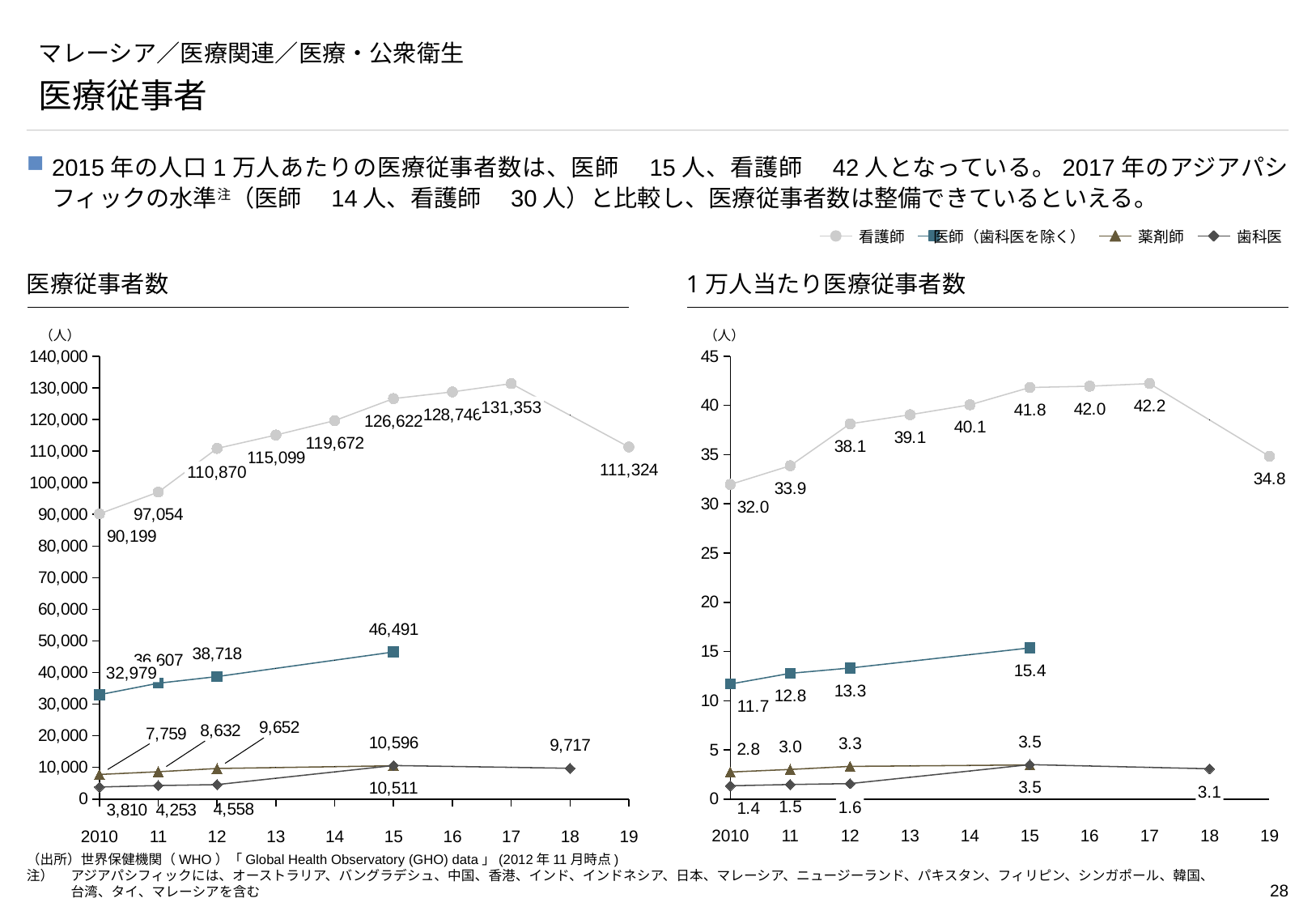
On the 1万人当たり医療従事者数 chart, what is the value for 医師（歯科医を除く） in 2015? 15.4 On the 医療従事者数 chart, what is the difference between the 看護師 values in 2017 and 2019? 20,029 On the 1万人当たり医療従事者数 chart, is the 看護師 value in 2019 greater or less than 35? less On the 1万人当たり医療従事者数 chart, what is the value for 看護師 in 2015? 41.8 On the 1万人当たり医療従事者数 chart, what is the difference between the 医師（歯科医を除く） values in 2015 and 2010? 3.7 On the 医療従事者数 chart, what is the value for 医師（歯科医を除く） in 2015? 46,491 On the 医療従事者数 chart, in which year is the 看護師 value highest? 2017 On the 医療従事者数 chart, what is the value for 看護師 in 2017? 131,353 On the 医療従事者数 chart, what is the value for 歯科医 in 2010? 3,810 What kind of chart is the 医療従事者数 chart? line chart How many series does the legend list? 4 On the 医療従事者数 chart, what is the value for 看護師 in 2019? 111,324